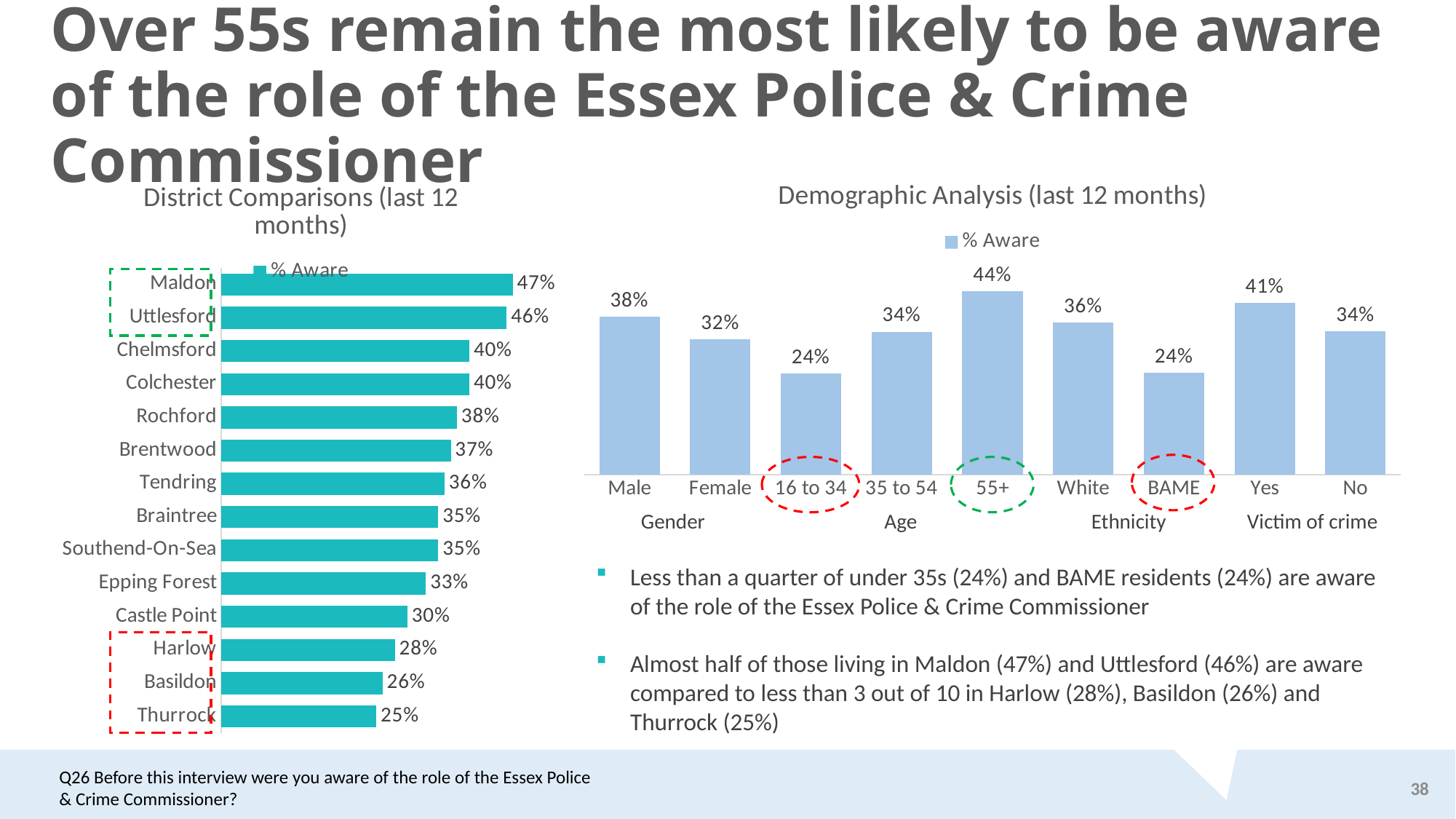
What type of chart is the Demographic Analysis chart? Bar chart In the District Comparisons chart, what is the difference in % Aware between Maldon and Thurrock? 22 percentage points In the District Comparisons chart, what is the % Aware value for Maldon? 47% In the District Comparisons chart, what is the % Aware value for Epping Forest? 33% In the Demographic Analysis chart, what series name does the legend show? % Aware In the Demographic Analysis chart, what is the difference in % Aware between Male and Female? 6 percentage points In the Demographic Analysis chart, how many categories are plotted? 9 In the District Comparisons chart, which district has the lowest % Aware? Thurrock In the Demographic Analysis chart, which category has the highest % Aware? 55+ In the District Comparisons chart, which has a higher % Aware, Rochford or Castle Point? Rochford In the District Comparisons chart, how many districts are shown? 14 In the Demographic Analysis chart, what is the % Aware value for BAME? 24%